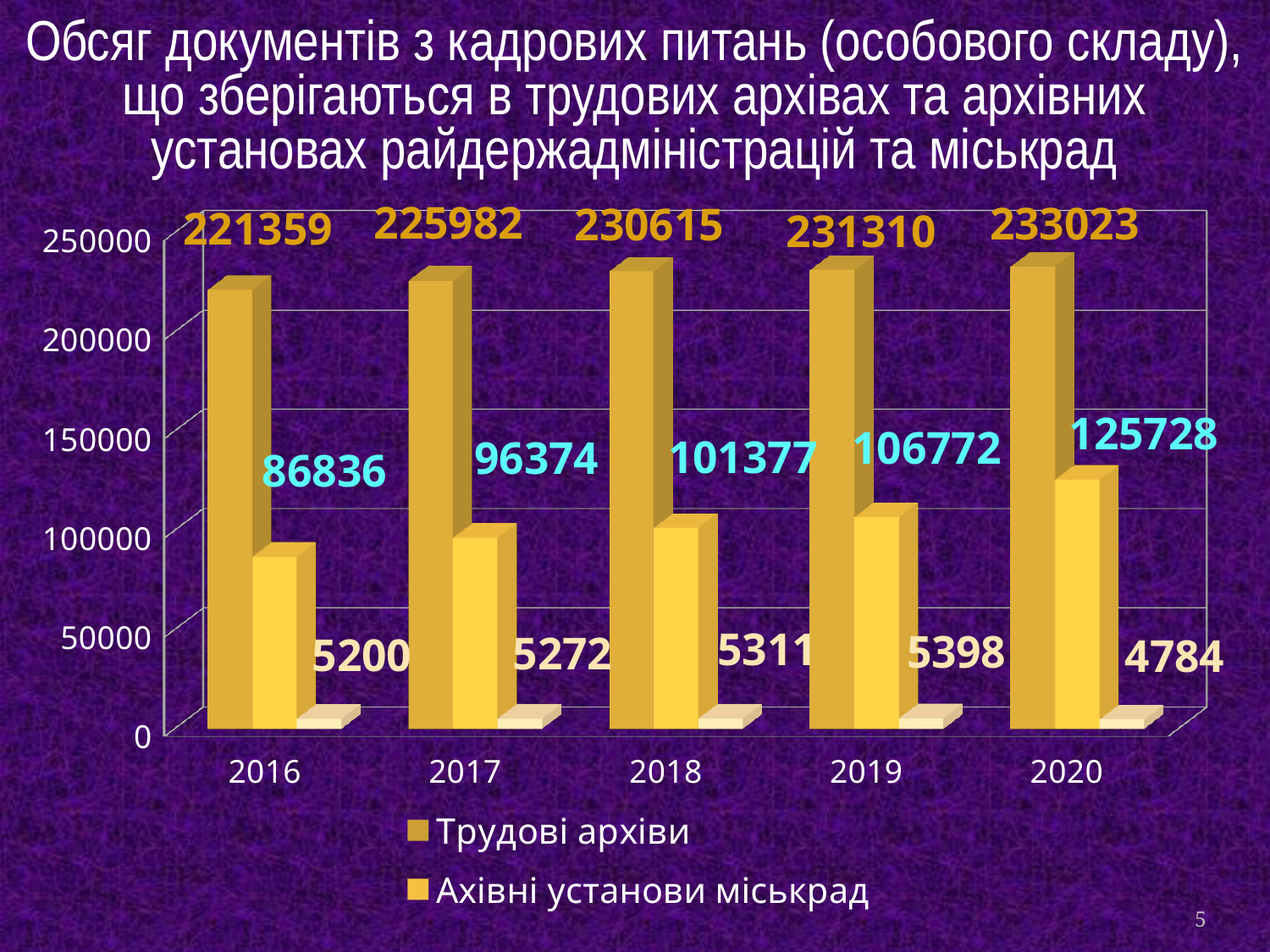
What is the value for Ахівні установи міськрад in 2020? 125728 What kind of chart is shown on the slide? bar chart How many series does the legend list? 2 What is the value for Трудові архіви in 2016? 221359 What is the value for Ахівні установи міськрад in 2018? 101377 In which year is the value for Ахівні установи міськрад lowest? 2016 What is the difference between the Ахівні установи міськрад values for 2019 and 2018? 5395 Which is larger: Ахівні установи міськрад in 2017 or in 2019? 2019 How many years are shown on the x axis? 5 In which year is the value for Трудові архіви highest? 2020 Do the values for Ахівні установи міськрад rise or fall from 2016 to 2020? rise What is the difference between the Трудові архіви values for 2020 and 2016? 11664